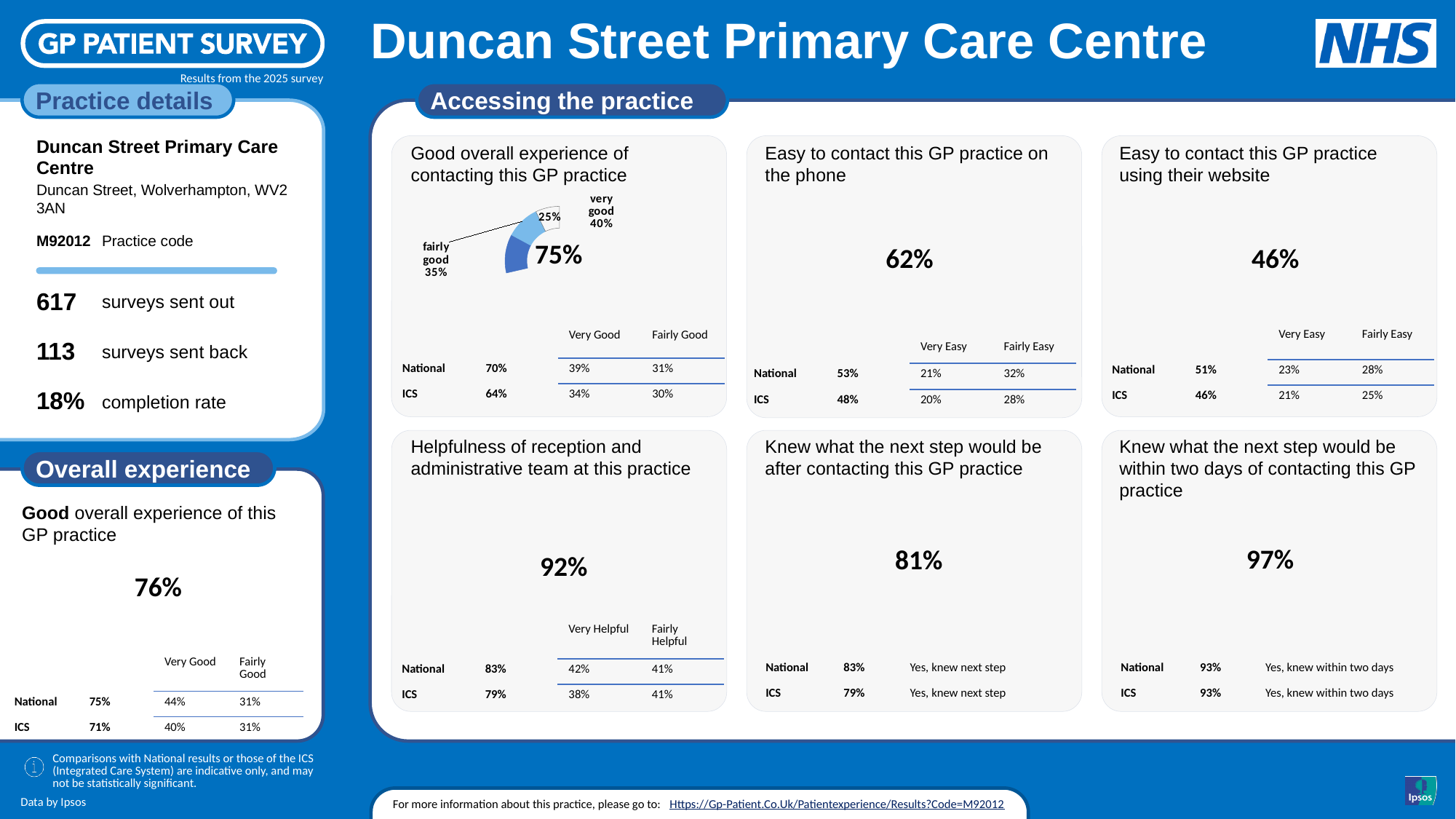
In the 'Good overall experience of contacting this GP practice' chart, what percentage is shown for the unlabelled remaining slice? 25% In the 'Good overall experience of contacting this GP practice' chart, what percentage is labelled 'fairly good'? 35% What kind of chart is shown in the 'Good overall experience of contacting this GP practice' panel? doughnut chart What value is printed in the centre of the 'Good overall experience of contacting this GP practice' chart? 75% In the 'Good overall experience of contacting this GP practice' panel, what is the National percentage shown in the table below the chart? 70% In the 'Good overall experience of contacting this GP practice' chart, which is larger: 'very good' or 'fairly good'? very good How many slices does the 'Good overall experience of contacting this GP practice' chart have? 3 In the 'Good overall experience of contacting this GP practice' panel, what is the ICS percentage shown in the table below the chart? 64% In the 'Good overall experience of contacting this GP practice' chart, which labelled slice is the largest? very good In the 'Good overall experience of contacting this GP practice' chart, what is the difference between the 'very good' and 'fairly good' percentages? 5% In the 'Good overall experience of contacting this GP practice' chart, what percentage is labelled 'very good'? 40% In the 'Good overall experience of contacting this GP practice' chart, what do the 'very good' and 'fairly good' slices add up to? 75%